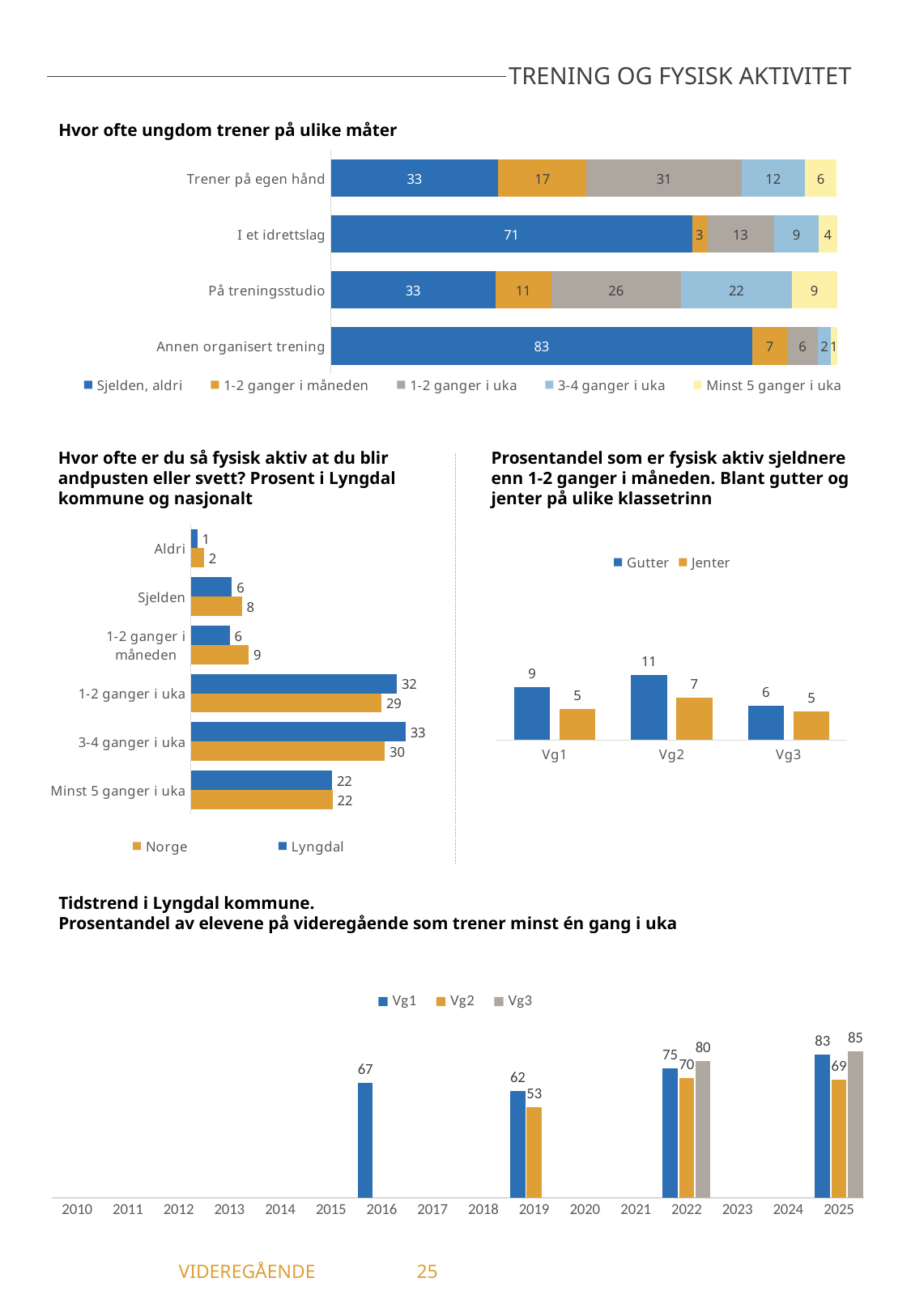
In the chart 'Hvor ofte ungdom trener på ulike måter', which category has the highest value for 'Sjelden, aldri'? Annen organisert trening In the chart 'Hvor ofte ungdom trener på ulike måter', what is the value for 'Sjelden, aldri' for 'I et idrettslag'? 71 In the chart 'Hvor ofte ungdom trener på ulike måter', what is the total of the stacked bar for 'Trener på egen hånd'? 99 How many series does the legend list in the chart 'Hvor ofte ungdom trener på ulike måter'? 5 In the chart 'Prosentandel som er fysisk aktiv sjeldnere enn 1-2 ganger i måneden', is the value for Gutter or Jenter larger at Vg1? Gutter In the chart 'Tidstrend i Lyngdal kommune', do the Vg1 values rise or fall from 2019 to 2025? Rise What kind of chart is 'Tidstrend i Lyngdal kommune'? Bar chart In the chart 'Hvor ofte er du så fysisk aktiv at du blir andpusten eller svett?', what is the Lyngdal value for '1-2 ganger i uka'? 32 In the chart 'Tidstrend i Lyngdal kommune', what is the value for Vg3 in 2025? 85 In the chart 'Hvor ofte er du så fysisk aktiv at du blir andpusten eller svett?', how many categories are shown? 6 In the chart 'Hvor ofte er du så fysisk aktiv at du blir andpusten eller svett?', what is the difference between the Norge and Lyngdal values for '1-2 ganger i måneden'? 3 In the chart 'Prosentandel som er fysisk aktiv sjeldnere enn 1-2 ganger i måneden', which class level has the highest value for Gutter? Vg2